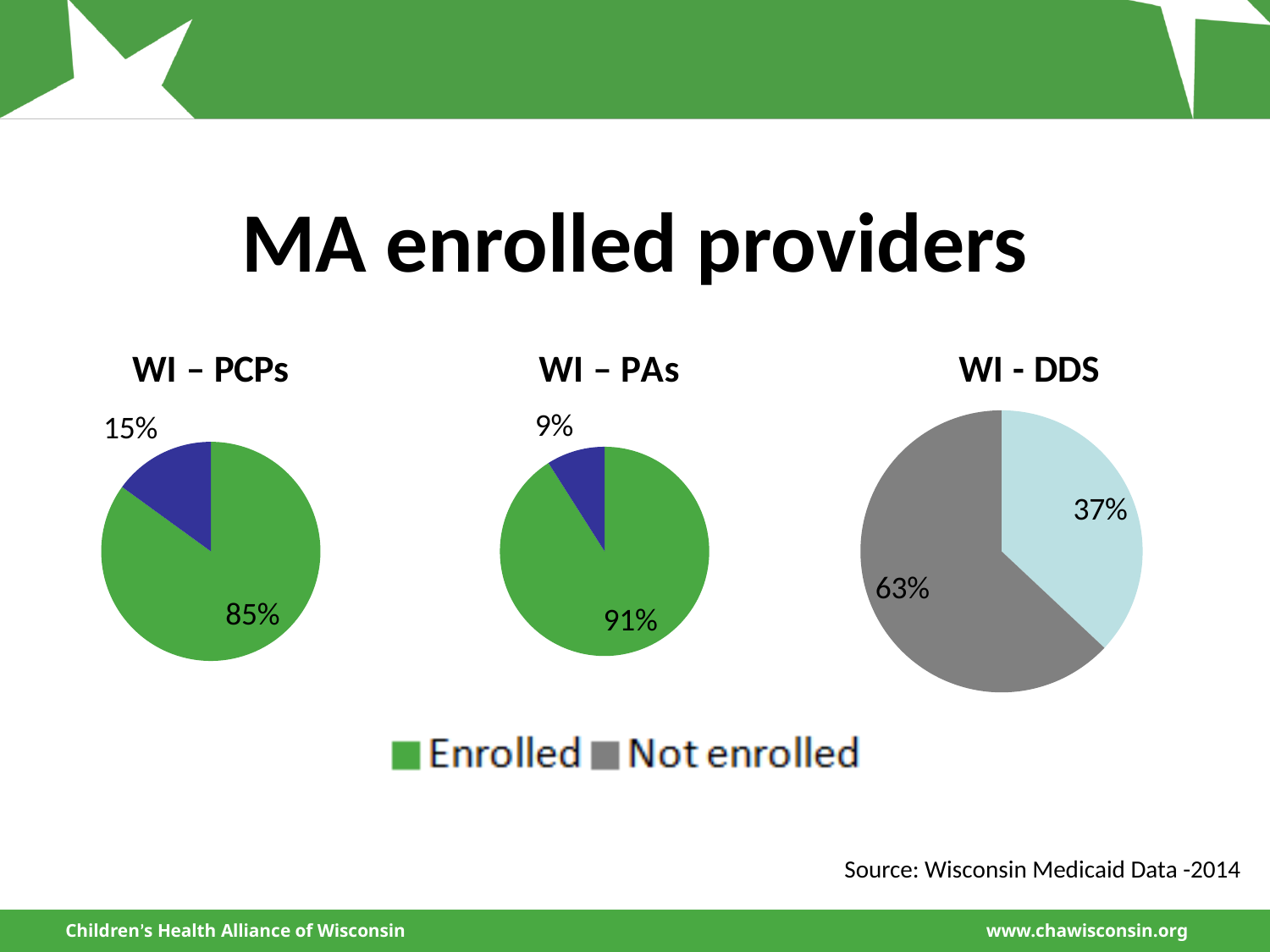
In the WI – PCPs chart, what percentage is shown for the smaller slice? 15% In the WI – PAs chart, what percentage of providers are enrolled? 91% In the WI - DDS chart, what percentage is shown for the light blue slice? 37% Which chart shows the highest enrolled percentage, WI – PCPs or WI – PAs? WI – PAs What type of chart is used for WI – PCPs? Pie chart How many entries does the legend list? 2 In the WI – PAs chart, what percentage is shown for the smaller slice? 9% What is the title of the slide? MA enrolled providers In the WI - DDS chart, what percentage is shown for the gray slice? 63% In the WI – PCPs chart, what percentage of providers are enrolled? 85% What is the difference between the enrolled percentages in the WI – PAs and WI – PCPs charts? 6% How many pie charts are shown on the slide? 3